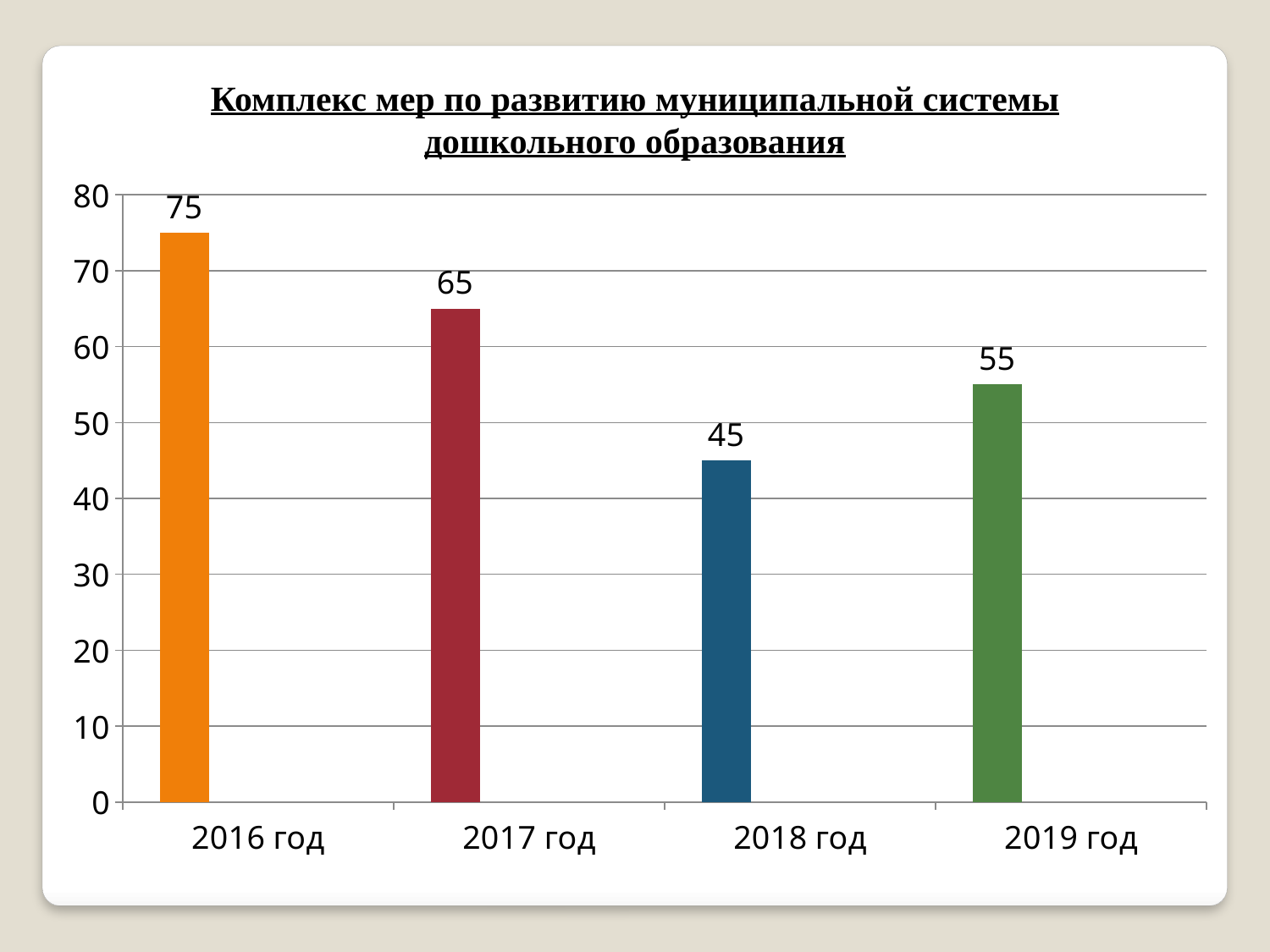
What is the difference between the values for 2016 год and 2017 год? 10 What colour is the bar for 2018 год? blue What kind of chart is shown on the slide? bar chart Which year has the highest value? 2016 год What is the difference between the values for 2019 год and 2018 год? 10 Which year has the lowest value? 2018 год What is the value for 2016 год? 75 What is the value for 2019 год? 55 What is the value for 2018 год? 45 Is the value for 2018 год greater or less than 50? less Which is larger, the value for 2017 год or the value for 2019 год? 2017 год How many years are shown on the x axis? 4